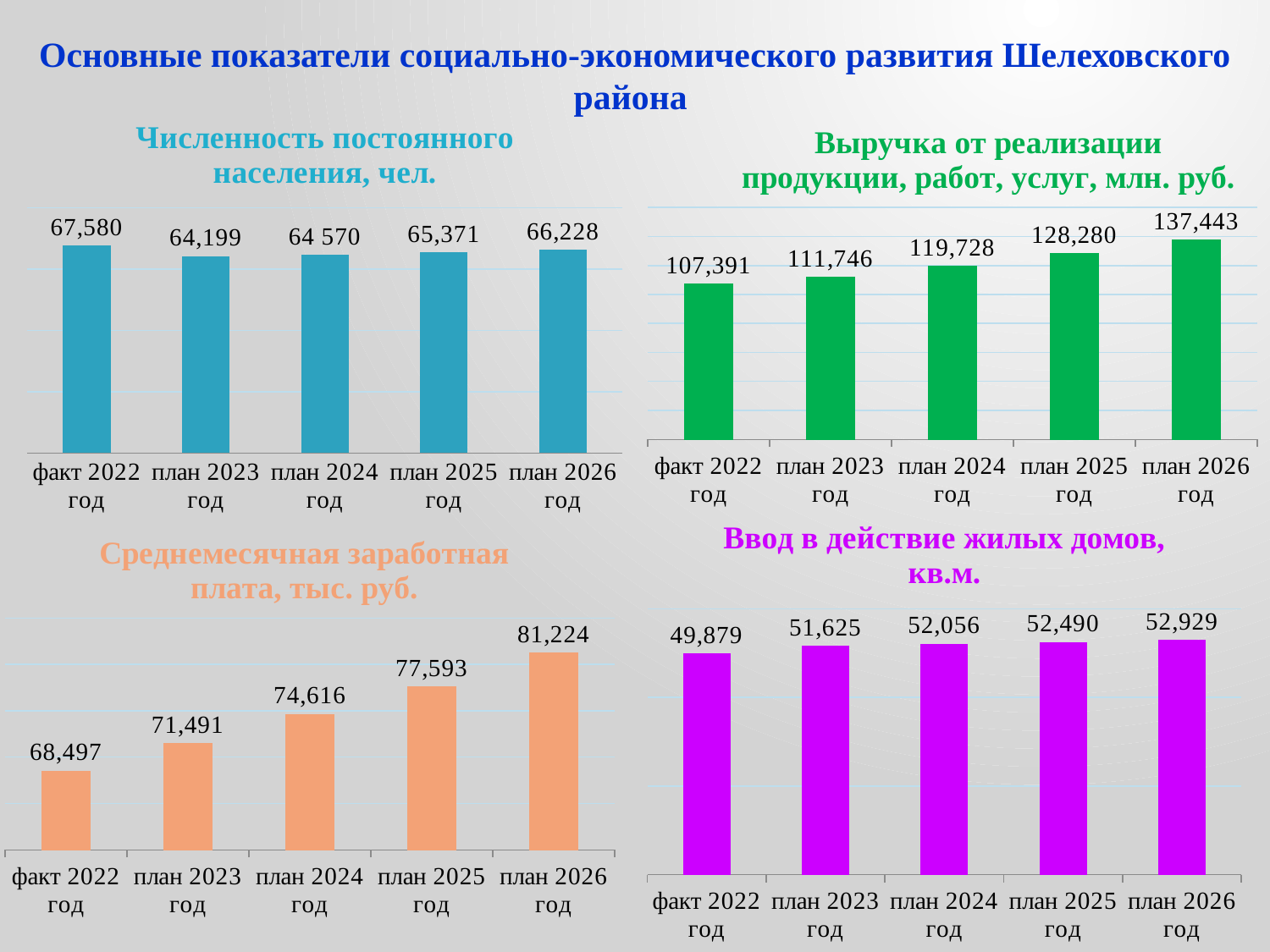
In the chart 'Ввод в действие жилых домов, кв.м.', what is the value for план 2023 год? 51,625 How many charts are on the slide, and what type are they? 4 bar charts In the chart 'Ввод в действие жилых домов, кв.м.', which is larger: факт 2022 год or план 2026 год? план 2026 год In the chart 'Численность постоянного населения, чел.', what is the value for факт 2022 год? 67,580 In the chart 'Среднемесячная заработная плата, тыс. руб.', what is the difference between план 2026 год and факт 2022 год? 12,727 In the chart 'Численность постоянного населения, чел.', what is the difference between факт 2022 год and план 2023 год? 3,381 In the chart 'Среднемесячная заработная плата, тыс. руб.', do the values rise or fall from факт 2022 год to план 2026 год? rise In the chart 'Среднемесячная заработная плата, тыс. руб.', what is the value for план 2024 год? 74,616 In the chart 'Выручка от реализации продукции, работ, услуг, млн. руб.', what is the difference between план 2026 год and факт 2022 год? 30,052 In the chart 'Численность постоянного населения, чел.', which category has the lowest value? план 2023 год In the chart 'Выручка от реализации продукции, работ, услуг, млн. руб.', which category has the highest value? план 2026 год In the chart 'Выручка от реализации продукции, работ, услуг, млн. руб.', what is the value for план 2025 год? 128,280